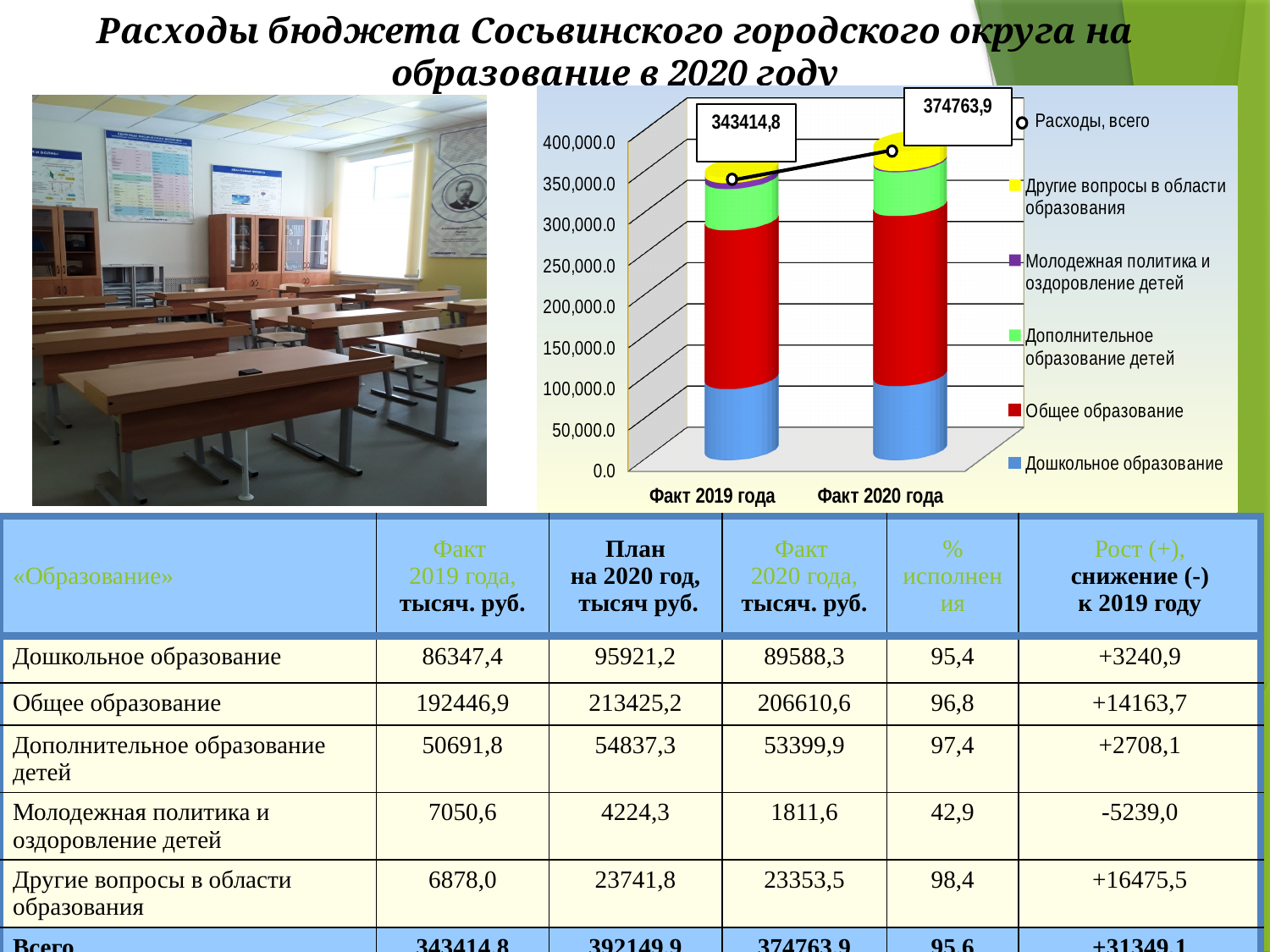
What kind of chart is shown on the slide? Stacked bar chart How many categories are shown on the x axis of the chart? 2 Does «Расходы, всего» rise or fall from Факт 2019 года to Факт 2020 года? Rises Which is larger, «Расходы, всего» for Факт 2019 года or for Факт 2020 года? Факт 2020 года Is the value of «Расходы, всего» for Факт 2020 года greater or less than 350,000.0? greater What is the value of «Расходы, всего» for Факт 2019 года? 343414,8 By how much does «Расходы, всего» for Факт 2020 года exceed the value for Факт 2019 года? 31349,1 What colour represents «Общее образование» in the chart? Red What is the value of «Расходы, всего» for Факт 2020 года? 374763,9 Which category has the lowest value of «Расходы, всего»? Факт 2019 года How many series does the chart legend list? 6 Is the value for «Дошкольное образование» in Факт 2019 года greater or less than 100,000.0? less